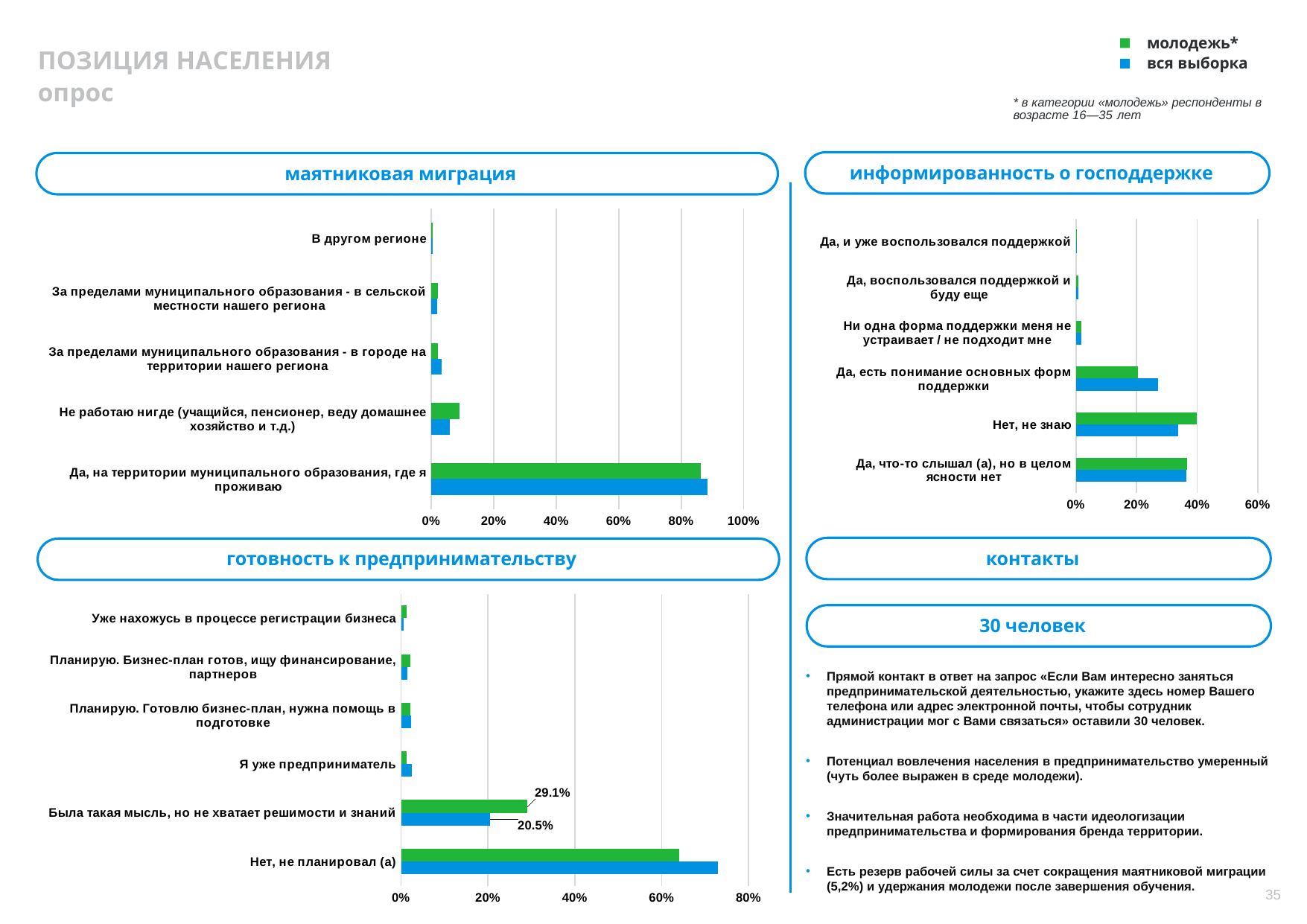
In the 'готовность к предпринимательству' chart, which series has the larger value for 'Была такая мысль, но не хватает решимости и знаний'? молодежь In the 'информированность о господдержке' chart, is the 'вся выборка' value for 'Да, есть понимание основных форм поддержки' greater or less than 20%? greater In the 'готовность к предпринимательству' chart, what is the value for 'молодежь' for 'Была такая мысль, но не хватает решимости и знаний'? 29.1% How many series does the legend list? 2 How many categories are shown in the 'маятниковая миграция' chart? 5 In the 'маятниковая миграция' chart, which category has the lowest values? В другом регионе What type of chart is the 'маятниковая миграция' chart? Bar chart In the 'готовность к предпринимательству' chart, what is the value for 'вся выборка' for 'Была такая мысль, но не хватает решимости и знаний'? 20.5% In the 'готовность к предпринимательству' chart, is the 'вся выборка' value for 'Нет, не планировал (а)' greater or less than 60%? greater In the 'готовность к предпринимательству' chart, what is the difference between the 'молодежь' and 'вся выборка' values for 'Была такая мысль, но не хватает решимости и знаний'? 8.6% In the 'маятниковая миграция' chart, which category has the highest values? Да, на территории муниципального образования, где я проживаю How many categories are shown in the 'информированность о господдержке' chart? 6